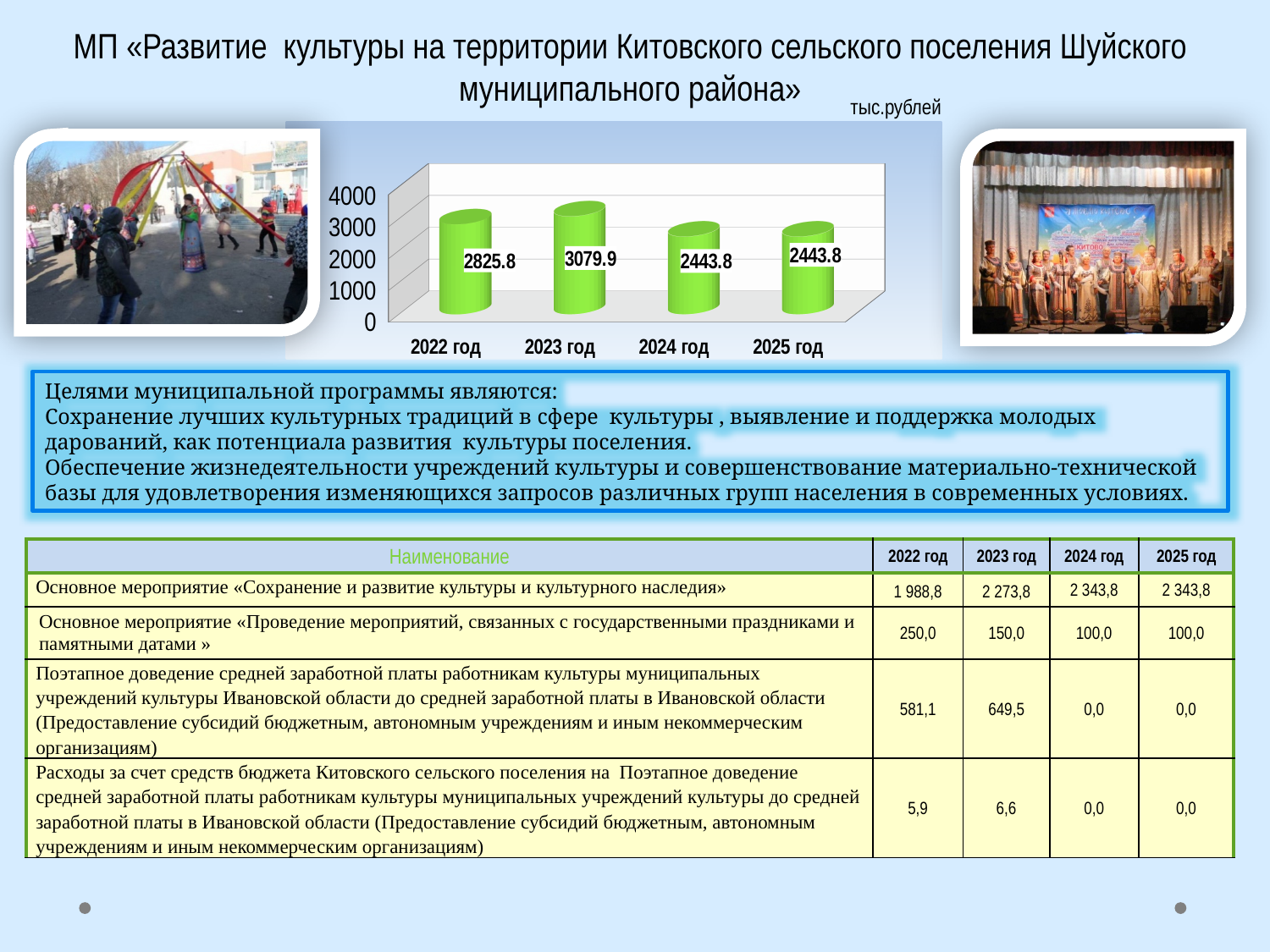
Which is larger on the chart, the value for 2022 год or the value for 2024 год? 2022 год What is the value shown for 2024 год on the chart? 2443.8 What unit is indicated above the chart? тыс.рублей What kind of chart is shown on the slide? bar chart Is the value for 2023 год on the chart greater or less than 3000? greater What is the value shown for 2023 год on the chart? 3079.9 Which year has the highest value on the chart? 2023 год What is the difference between the values for 2023 год and 2024 год on the chart? 636.1 What is the value shown for 2022 год on the chart? 2825.8 How many years are shown on the chart's x axis? 4 What is the difference between the values for 2023 год and 2022 год on the chart? 254.1 What is the value shown for 2025 год on the chart? 2443.8